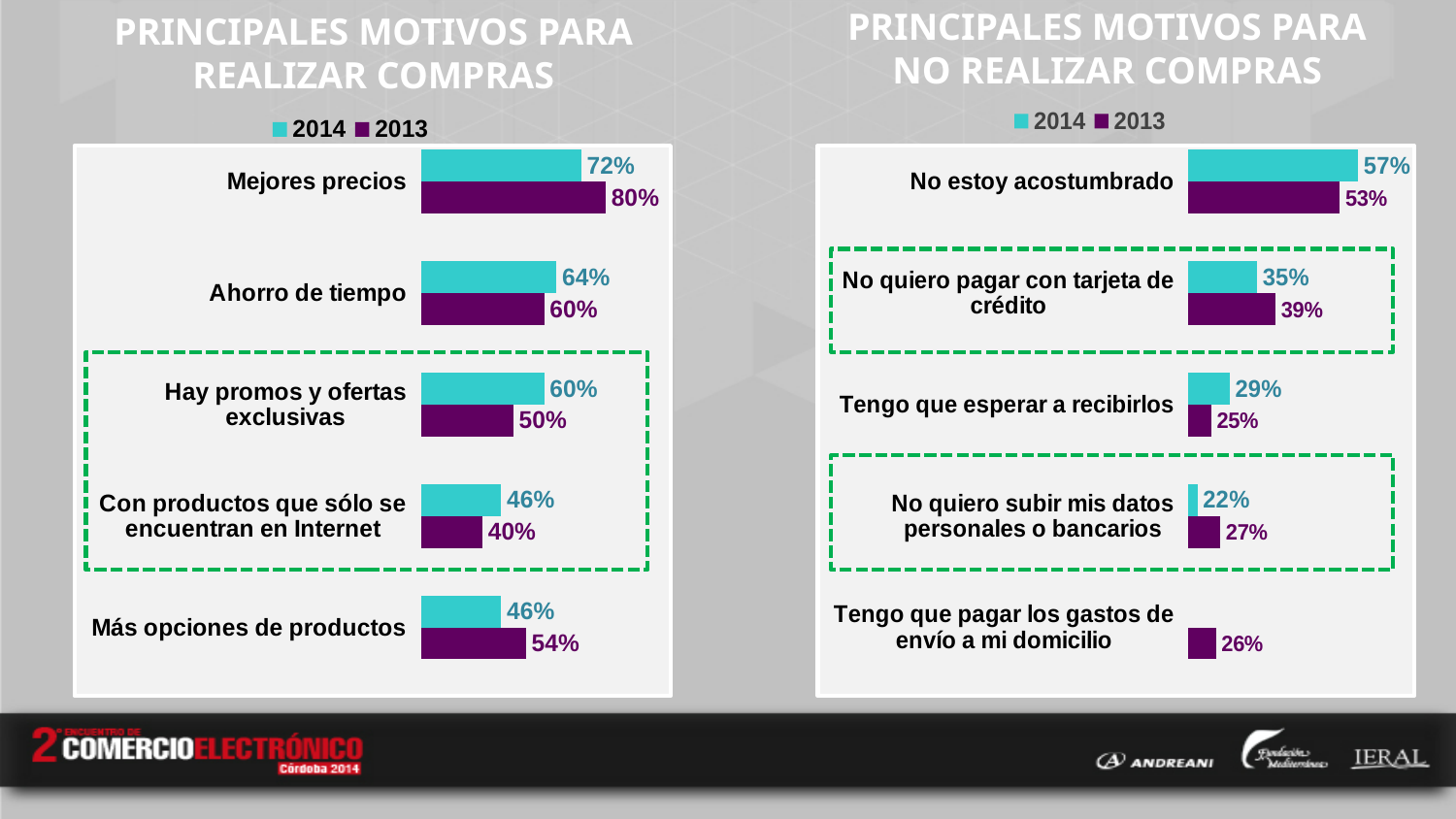
In the chart 'PRINCIPALES MOTIVOS PARA REALIZAR COMPRAS', what is the 2014 value for 'Mejores precios'? 72% In the chart 'PRINCIPALES MOTIVOS PARA NO REALIZAR COMPRAS', what is the difference between the 2013 and 2014 values for 'No quiero subir mis datos personales o bancarios'? 5% In the chart 'PRINCIPALES MOTIVOS PARA NO REALIZAR COMPRAS', what is the 2013 value for 'No quiero pagar con tarjeta de crédito'? 39% In the chart 'PRINCIPALES MOTIVOS PARA REALIZAR COMPRAS', what is the 2013 value for 'Más opciones de productos'? 54% In the chart 'PRINCIPALES MOTIVOS PARA REALIZAR COMPRAS', which category has the highest 2013 value? Mejores precios What type of chart is 'PRINCIPALES MOTIVOS PARA NO REALIZAR COMPRAS'? Bar chart In the chart 'PRINCIPALES MOTIVOS PARA NO REALIZAR COMPRAS', what is the 2014 value for 'No estoy acostumbrado'? 57% How many categories are shown in the chart 'PRINCIPALES MOTIVOS PARA REALIZAR COMPRAS'? 5 How many series does the legend list in the chart 'PRINCIPALES MOTIVOS PARA NO REALIZAR COMPRAS'? 2 In the chart 'PRINCIPALES MOTIVOS PARA REALIZAR COMPRAS', what is the difference between the 2013 and 2014 values for 'Mejores precios'? 8% In the chart 'PRINCIPALES MOTIVOS PARA REALIZAR COMPRAS', is the 2014 value for 'Ahorro de tiempo' larger or smaller than its 2013 value? larger